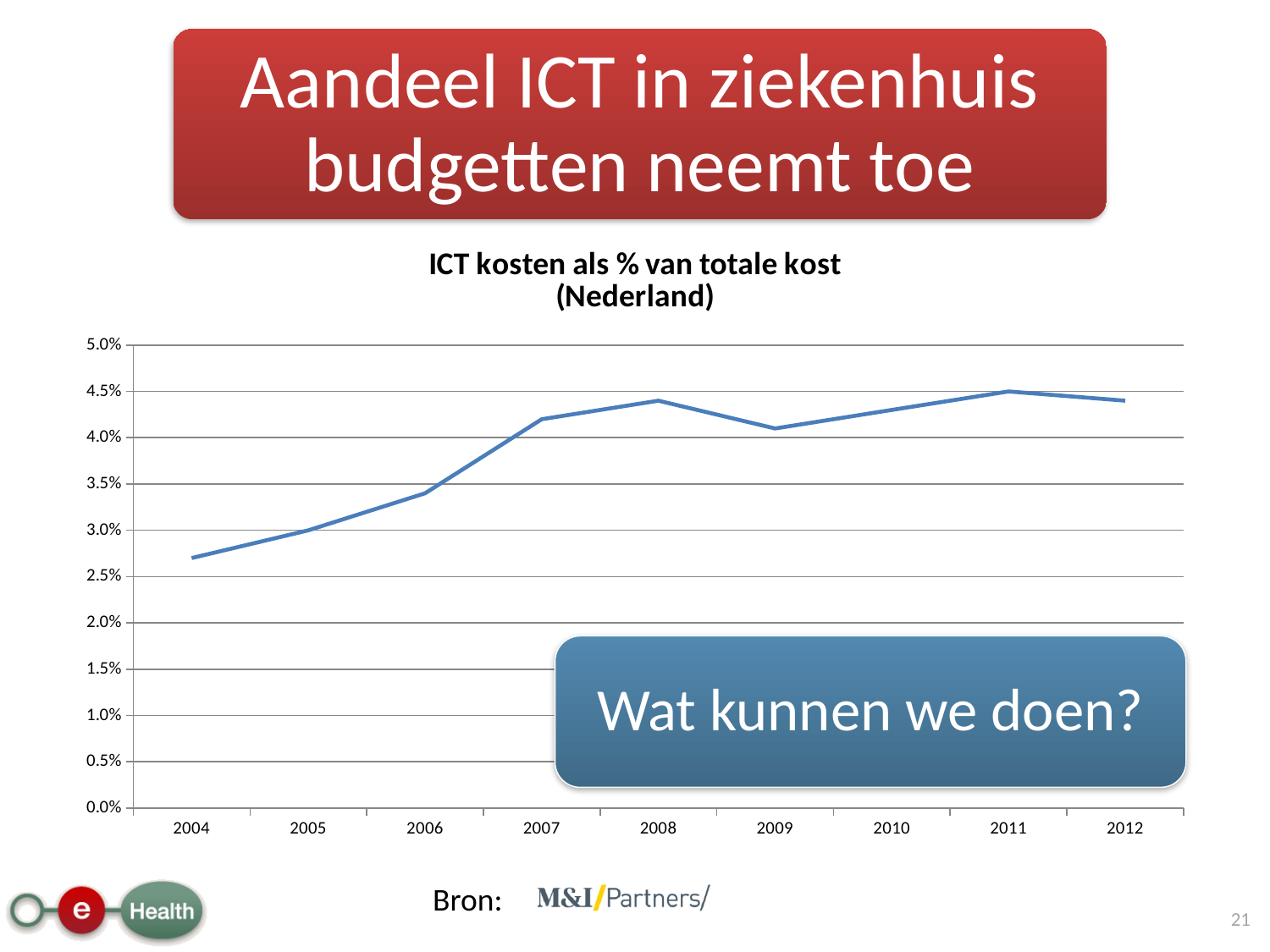
Is the value for 2012 greater or less than 4.0%? greater Is the value for 2011 greater or less than 4.0%? greater Which is larger, the value for 2006 or the value for 2010? 2010 What is the title of the chart? ICT kosten als % van totale kost (Nederland) How many years are plotted on the x axis of the chart? 9 Is the value for 2007 greater or less than 4.0%? greater Which year has the lowest ICT cost share in the chart? 2004 What kind of chart is shown on the slide? line chart Overall, do the values rise or fall from 2004 to 2012? rise Which is larger, the value for 2004 or the value for 2008? 2008